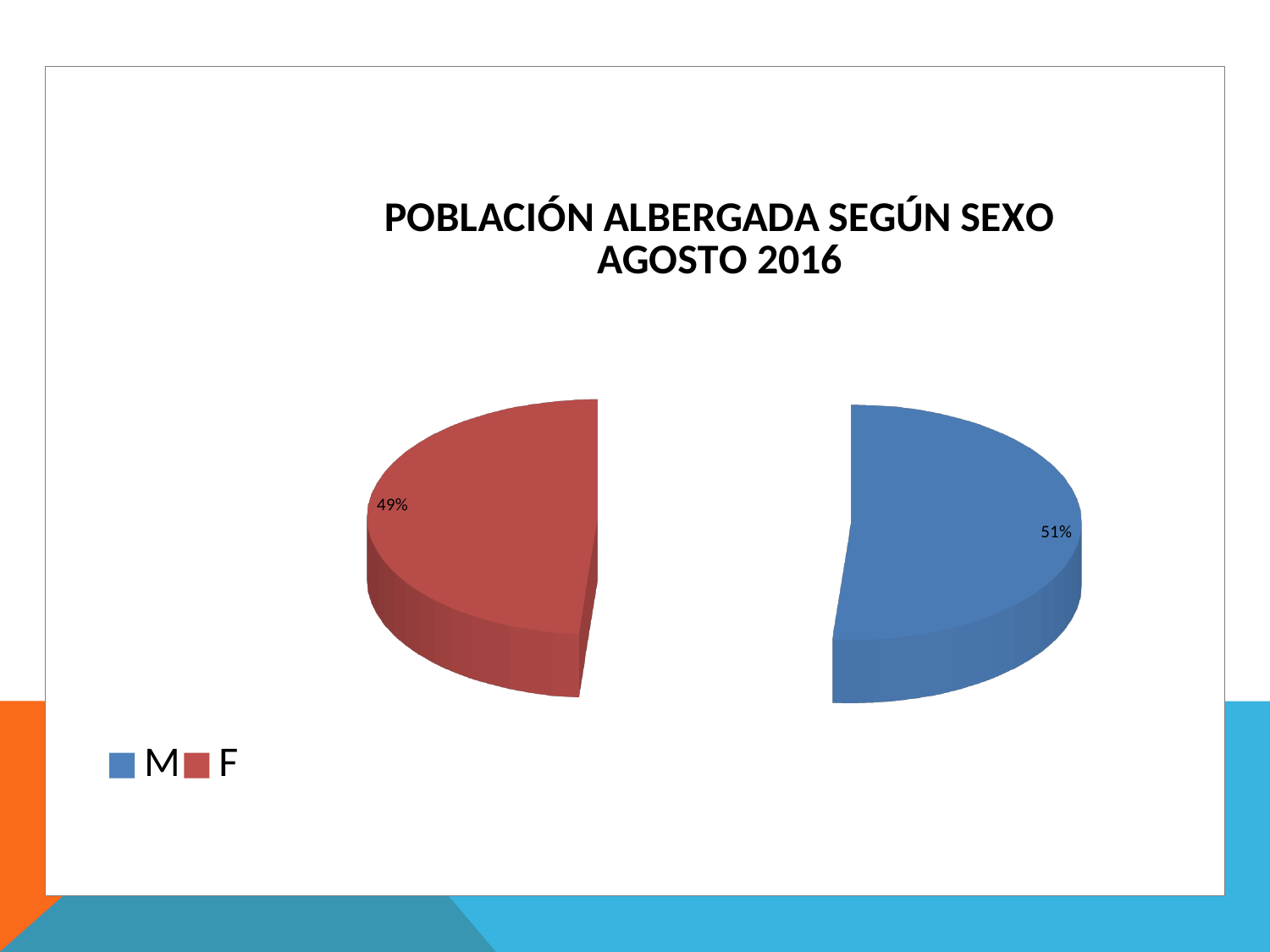
How many slices does the pie chart have? 2 What colour is the slice for F? Red What share of the pie does F represent? 49% Is the value for M greater or less than 50%? greater What share of the pie does M represent? 51% What is the title of the chart? POBLACIÓN ALBERGADA SEGÚN SEXO AGOSTO 2016 Which category has the largest slice of the pie? M What is the difference in percentage points between the M and F slices? 2% Which slice is larger, M or F? M Which category has the smallest slice of the pie? F What kind of chart is shown on the slide? Pie chart Is the value for F greater or less than 50%? less